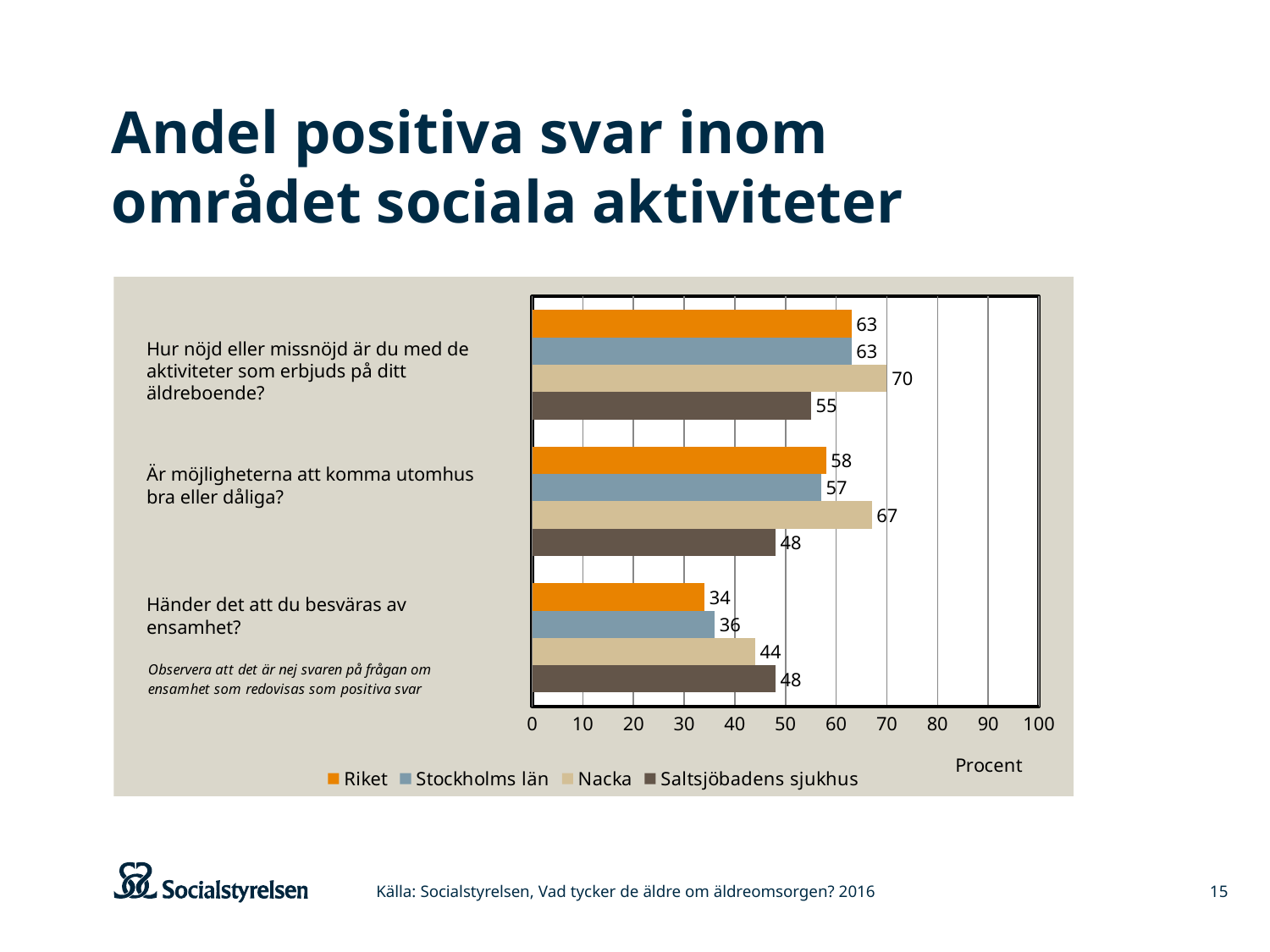
What kind of chart is shown on the slide? Bar chart What is the difference between Nacka and Saltsjöbadens sjukhus on the question "Hur nöjd eller missnöjd är du med de aktiviteter som erbjuds på ditt äldreboende?"? 15 What is the value for Riket on the question "Händer det att du besväras av ensamhet?"? 34 How many questions (categories) are shown on the chart? 3 Is the value for Stockholms län on the question "Är möjligheterna att komma utomhus bra eller dåliga?" greater or less than 50? greater How many series does the legend list? 4 What is the value for Nacka on the question "Hur nöjd eller missnöjd är du med de aktiviteter som erbjuds på ditt äldreboende?"? 70 Which series has the lowest value on the question "Hur nöjd eller missnöjd är du med de aktiviteter som erbjuds på ditt äldreboende?"? Saltsjöbadens sjukhus What is the value for Saltsjöbadens sjukhus on the question "Är möjligheterna att komma utomhus bra eller dåliga?"? 48 What is the label of the horizontal axis? Procent Which series has the highest value on the question "Är möjligheterna att komma utomhus bra eller dåliga?"? Nacka Which is larger on the question "Händer det att du besväras av ensamhet?": Nacka or Saltsjöbadens sjukhus? Saltsjöbadens sjukhus